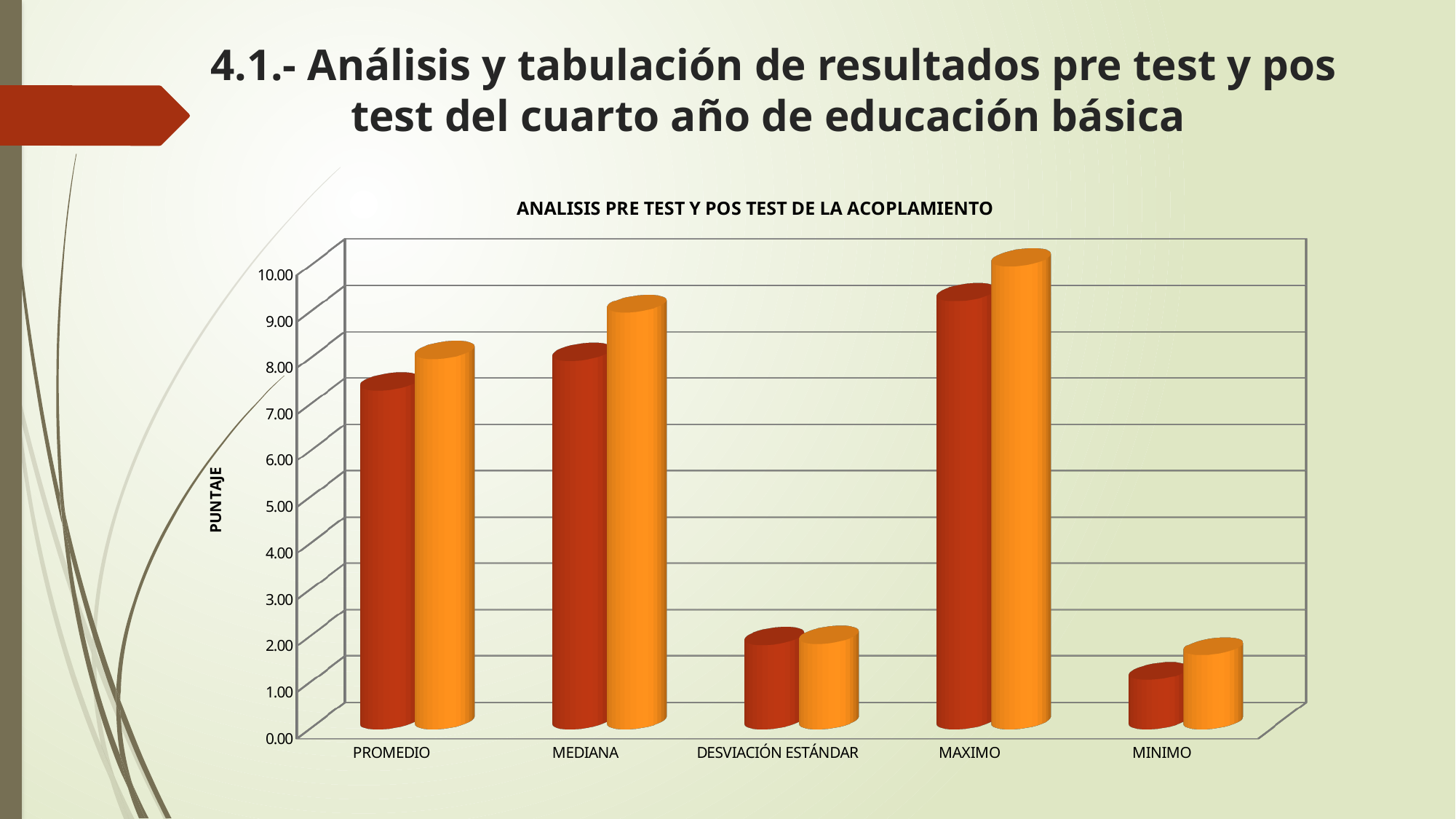
Which category has the shortest bar in the chart? MINIMO Which category has the tallest bar in the chart? MAXIMO For PROMEDIO, which bar is taller, the dark red bar or the orange bar? the orange bar Is the dark red bar for MINIMO greater or less than 2.00? less What is the title of the chart? ANALISIS PRE TEST Y POS TEST DE LA ACOPLAMIENTO What is the label on the vertical axis of the chart? PUNTAJE How many categories are shown on the x axis of the chart? 5 Is the orange bar for DESVIACIÓN ESTÁNDAR greater or less than 3.00? less Is the dark red bar for MAXIMO greater or less than 8.00? greater What kind of chart is shown on the slide? bar chart Which category has a taller orange bar, MEDIANA or MINIMO? MEDIANA